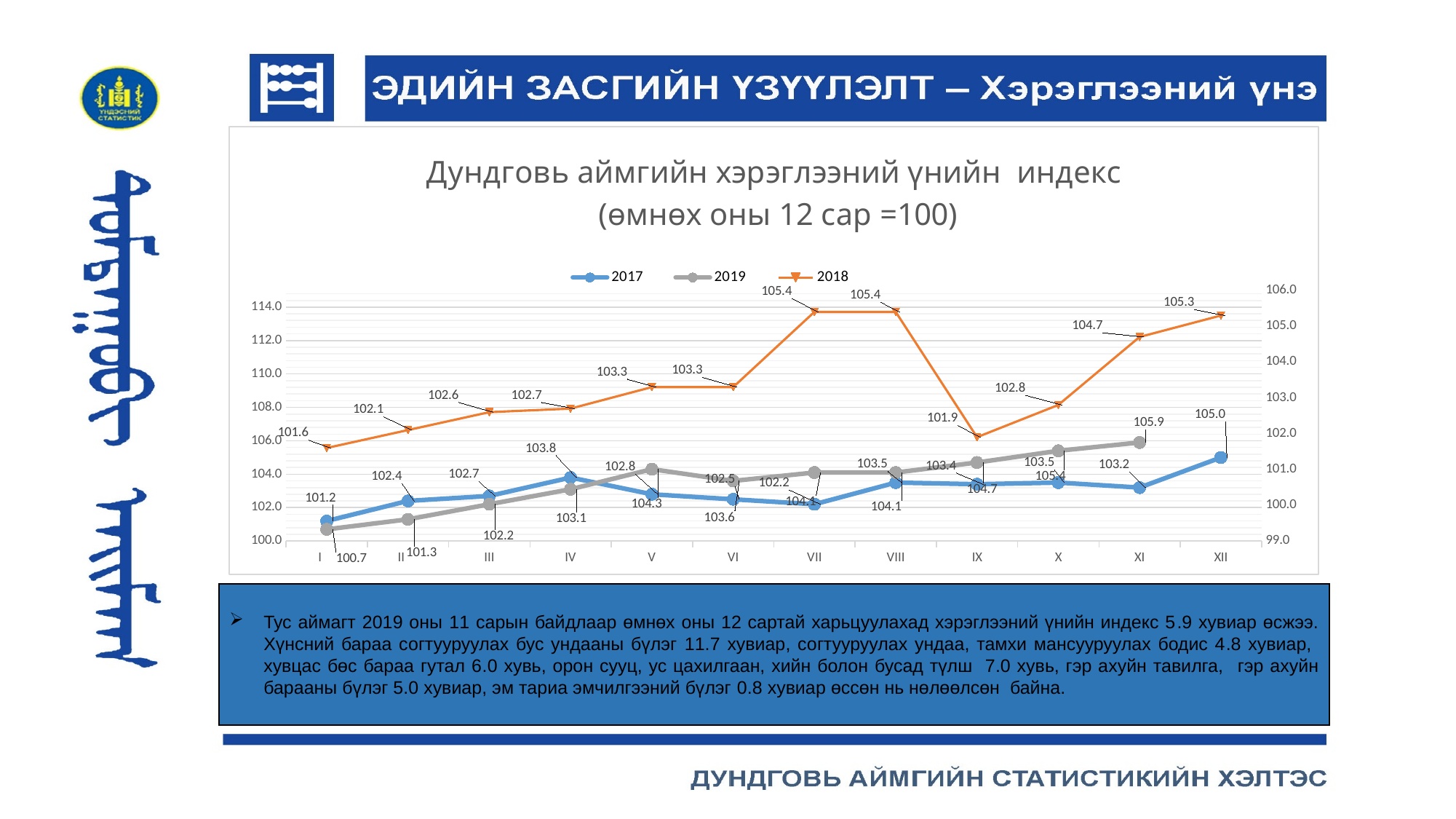
Which series is listed first in the chart legend? 2017 What is the difference between the 2018 values in month XII and month I? 3.7 What type of chart is shown on the slide? Line chart In which month is the 2018 series at its lowest value? I What is the value of the 2018 series in month IX? 101.9 What is the value of the 2019 series in month XI? 105.9 What is the value of the 2019 series in month I? 100.7 What is the value of the 2018 series in month XII? 105.3 What is the value of the 2018 series in month I? 101.6 How many months (categories) are shown on the x axis of the chart? 12 How many series does the chart legend list? 3 Which is larger for the 2018 series: the value in month VII or the value in month IX? Month VII